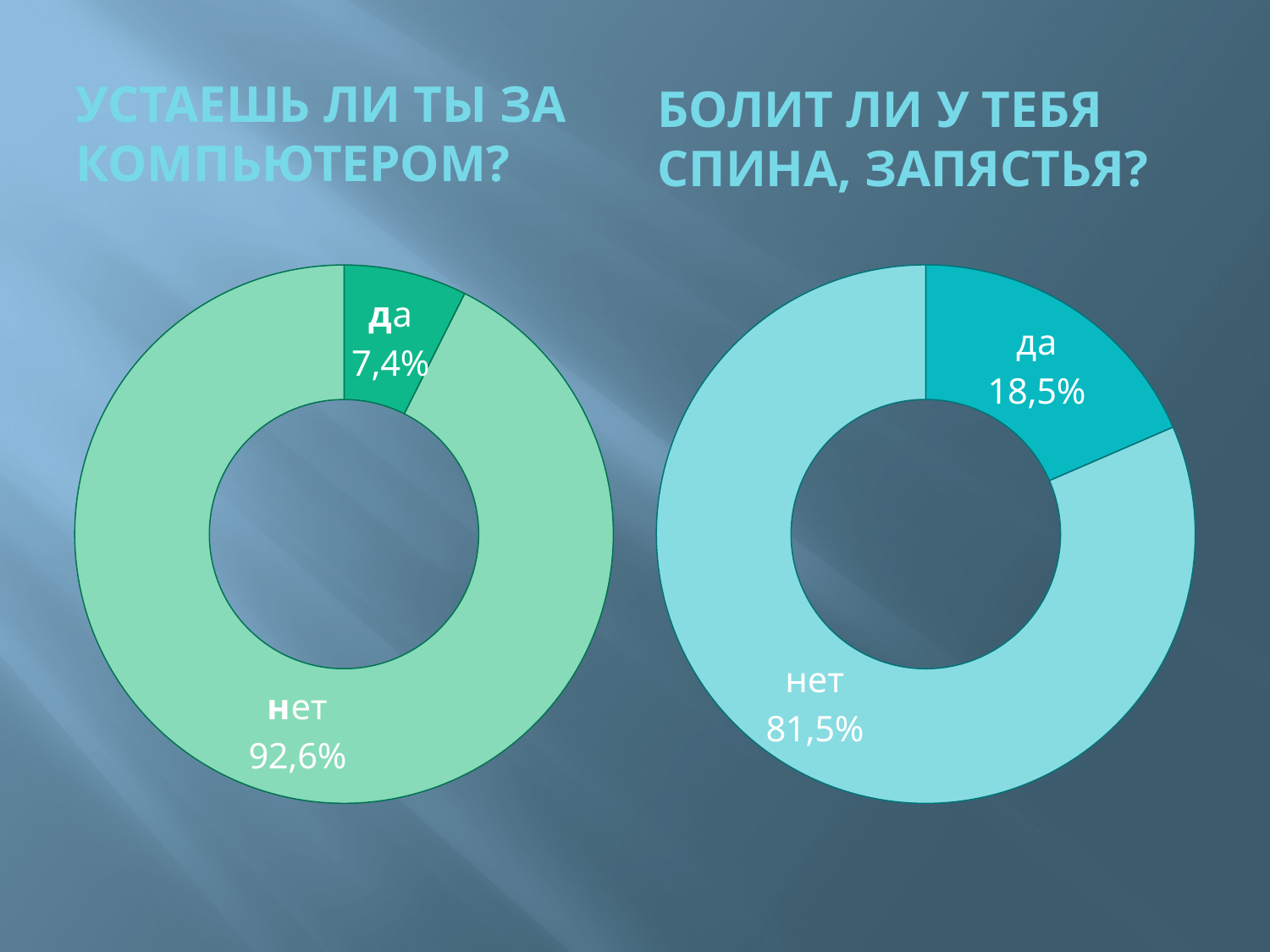
In the chart titled 'Устаешь ли ты за компьютером?', what is the value for 'да'? 7,4% Which is larger: the 'да' share in the left chart or the 'да' share in the right chart? the right chart How many categories does the chart on the right show? 2 In the chart titled 'Болит ли у тебя спина, запястья?', what is the difference between 'нет' and 'да'? 63,0% In the chart on the right, which category has the smallest share? да What kind of chart is used on the left side of the slide? doughnut chart In the chart titled 'Болит ли у тебя спина, запястья?', what is the value for 'нет'? 81,5% In the chart titled 'Болит ли у тебя спина, запястья?', what is the value for 'да'? 18,5% In the chart titled 'Устаешь ли ты за компьютером?', what is the value for 'нет'? 92,6% In the chart titled 'Устаешь ли ты за компьютером?', what is the difference between 'нет' and 'да'? 85,2% In the chart on the left, which category has the largest share? нет What is the title of the chart on the right? Болит ли у тебя спина, запястья?